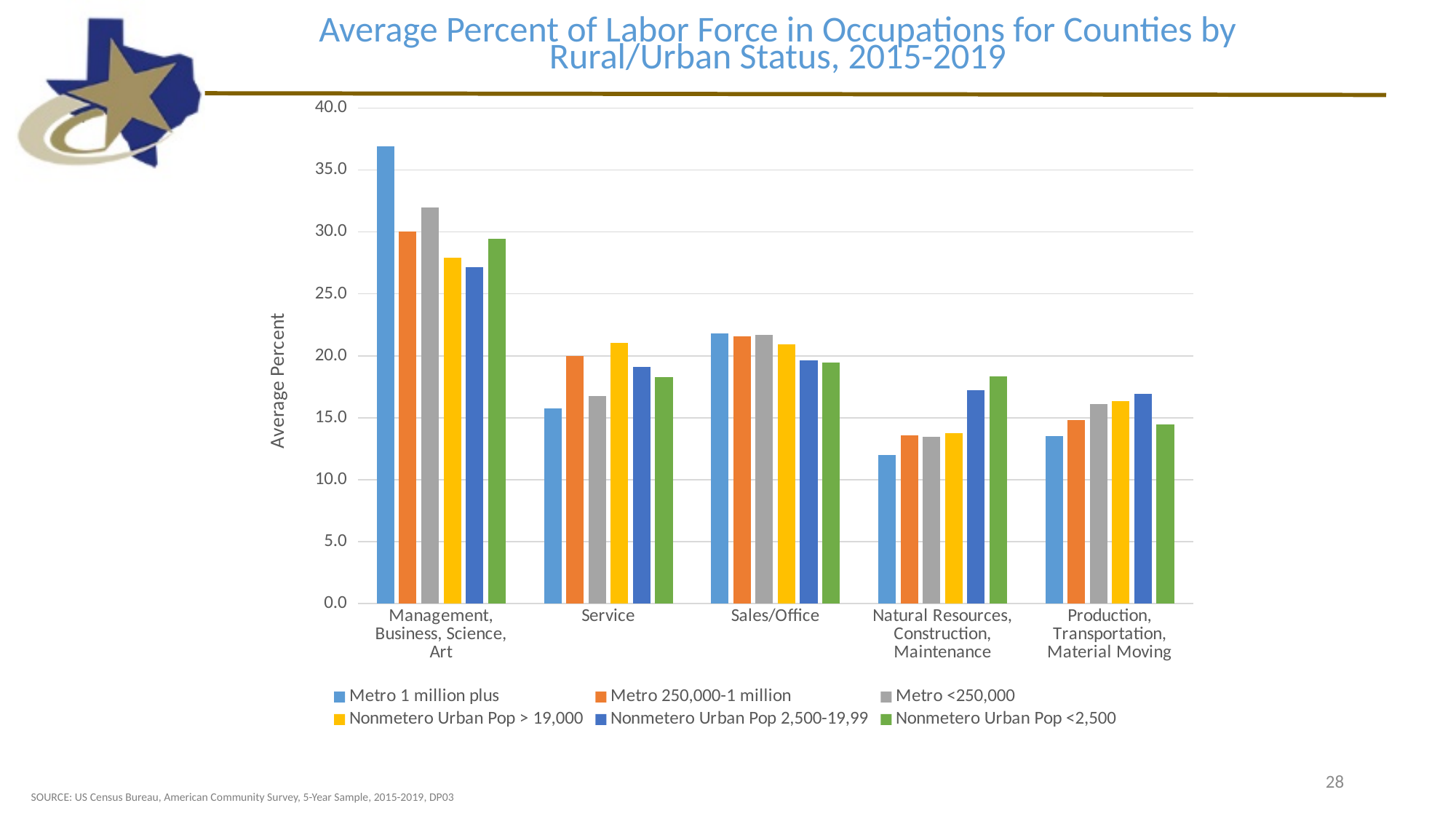
Is the value for Nonmetero Urban Pop <2,500 in Management, Business, Science, Art greater or less than 25.0? greater What is the label on the vertical axis? Average Percent In which occupation category is the Metro 1 million plus bar the lowest? Natural Resources, Construction, Maintenance What kind of chart is shown on the slide? Bar chart Within Management, Business, Science, Art, which series has the highest bar? Metro 1 million plus In which occupation category is the Metro 1 million plus bar the highest? Management, Business, Science, Art How many series does the legend list? 6 Is the value for Metro 1 million plus in Management, Business, Science, Art greater or less than 35.0? greater In Service, which is larger: Metro 250,000-1 million or Metro <250,000? Metro 250,000-1 million Is the value for Metro 1 million plus in Service greater or less than 20.0? less In Natural Resources, Construction, Maintenance, which is larger: Nonmetero Urban Pop <2,500 or Metro 1 million plus? Nonmetero Urban Pop <2,500 How many occupation categories are shown on the x axis? 5